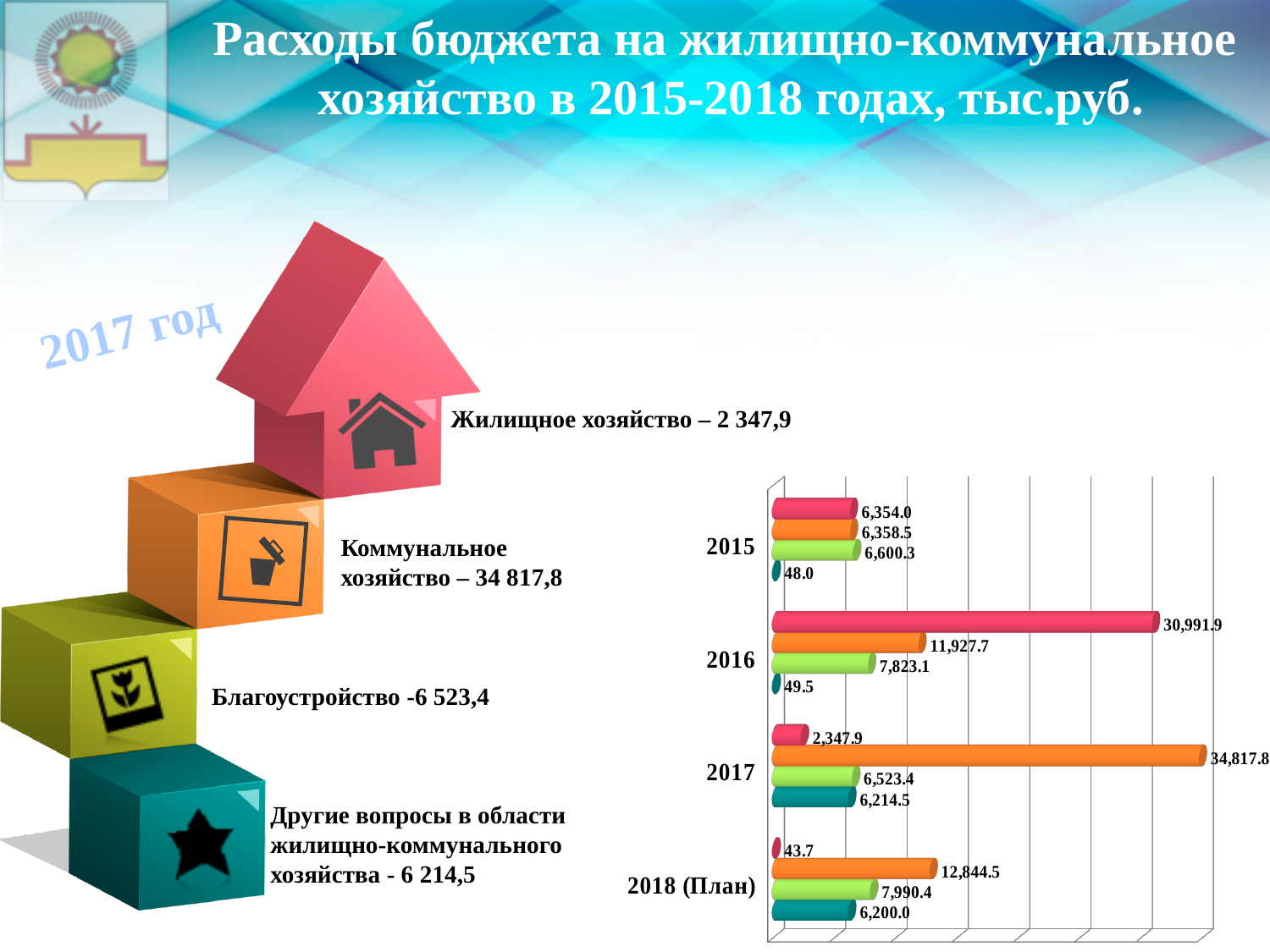
What is the value of the teal bar for 2015? 48.0 What is the value of the green bar for 2018 (План)? 7,990.4 What is the value of the red bar for 2016? 30,991.9 What is the value of the orange bar for 2017? 34,817.8 In which year is the orange bar the longest? 2017 What is the difference between the green bar and the teal bar for 2017? 308.9 How many year categories are shown on the chart's vertical axis? 4 What kind of chart is shown on the slide? bar chart Which is larger: the green bar for 2016 or the green bar for 2017? 2016 What is the difference between the orange bar for 2018 (План) and the orange bar for 2016? 916.8 How many bars are plotted for each year on the chart? 4 In which year is the red bar the shortest? 2018 (План)